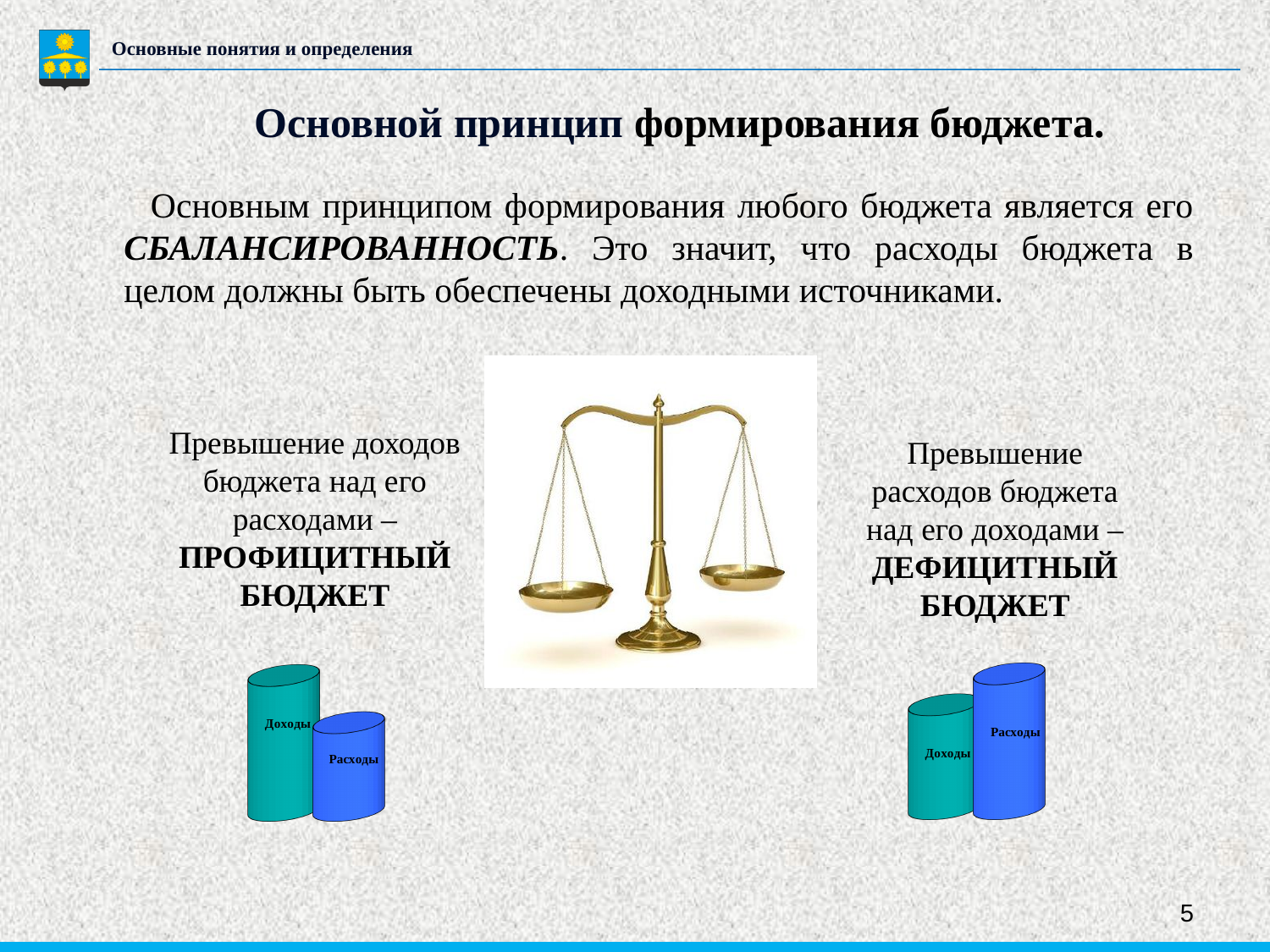
In the bar chart at the bottom right of the slide (under ДЕФИЦИТНЫЙ БЮДЖЕТ), which bar is taller, Доходы or Расходы? Расходы In the bar chart at the bottom left of the slide (under ПРОФИЦИТНЫЙ БЮДЖЕТ), which bar is taller, Доходы or Расходы? Доходы In the bar chart at the bottom left of the slide, which category has the lowest bar? Расходы In the bar chart at the bottom right of the slide, which category has the highest bar? Расходы In the bar chart at the bottom left of the slide, what colour is the Доходы bar? Teal (green) In the bar chart at the bottom right of the slide, which category has the lowest bar? Доходы How many bars are shown in the bar chart at the bottom left of the slide? 2 What kind of chart is shown at the bottom left of the slide? Bar chart How many bars are shown in the bar chart at the bottom right of the slide? 2 In the bar chart at the bottom left of the slide, which category has the highest bar? Доходы In the bar chart at the bottom right of the slide, what colour is the Расходы bar? Blue